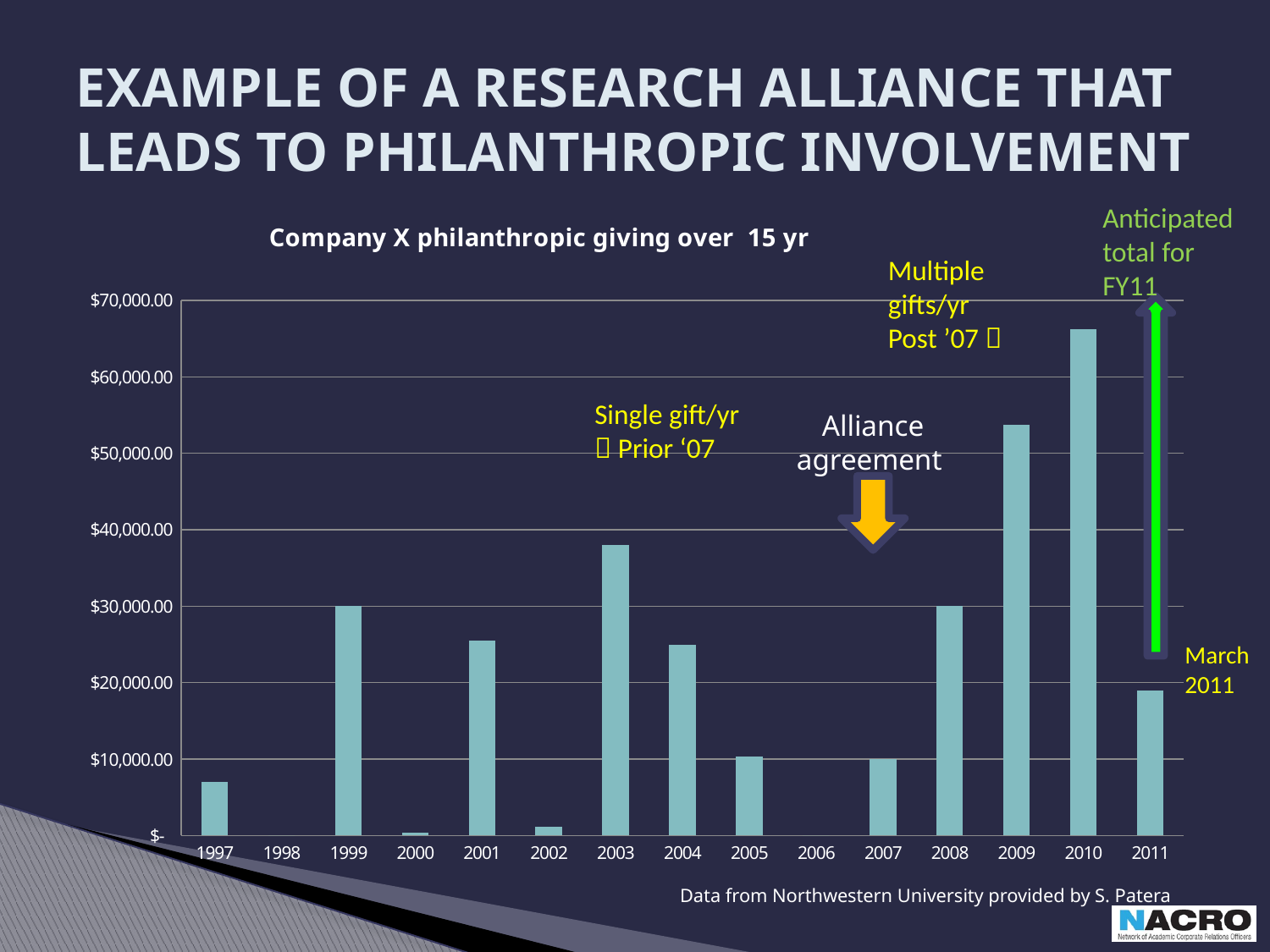
Do the values rise or fall from 2007 to 2010? rise Is the value for 2010 greater or less than $60,000.00? greater Is the value for 2011 greater or less than $20,000.00? less How many years are shown on the x axis of the chart? 15 What is the title of the chart? Company X philanthropic giving over 15 yr Which year has the highest philanthropic giving? 2010 What kind of chart is shown on the slide? Bar chart Which year has the larger value, 2009 or 2011? 2009 Is the value for 2009 greater or less than $50,000.00? greater Which year has the larger value, 2003 or 2004? 2003